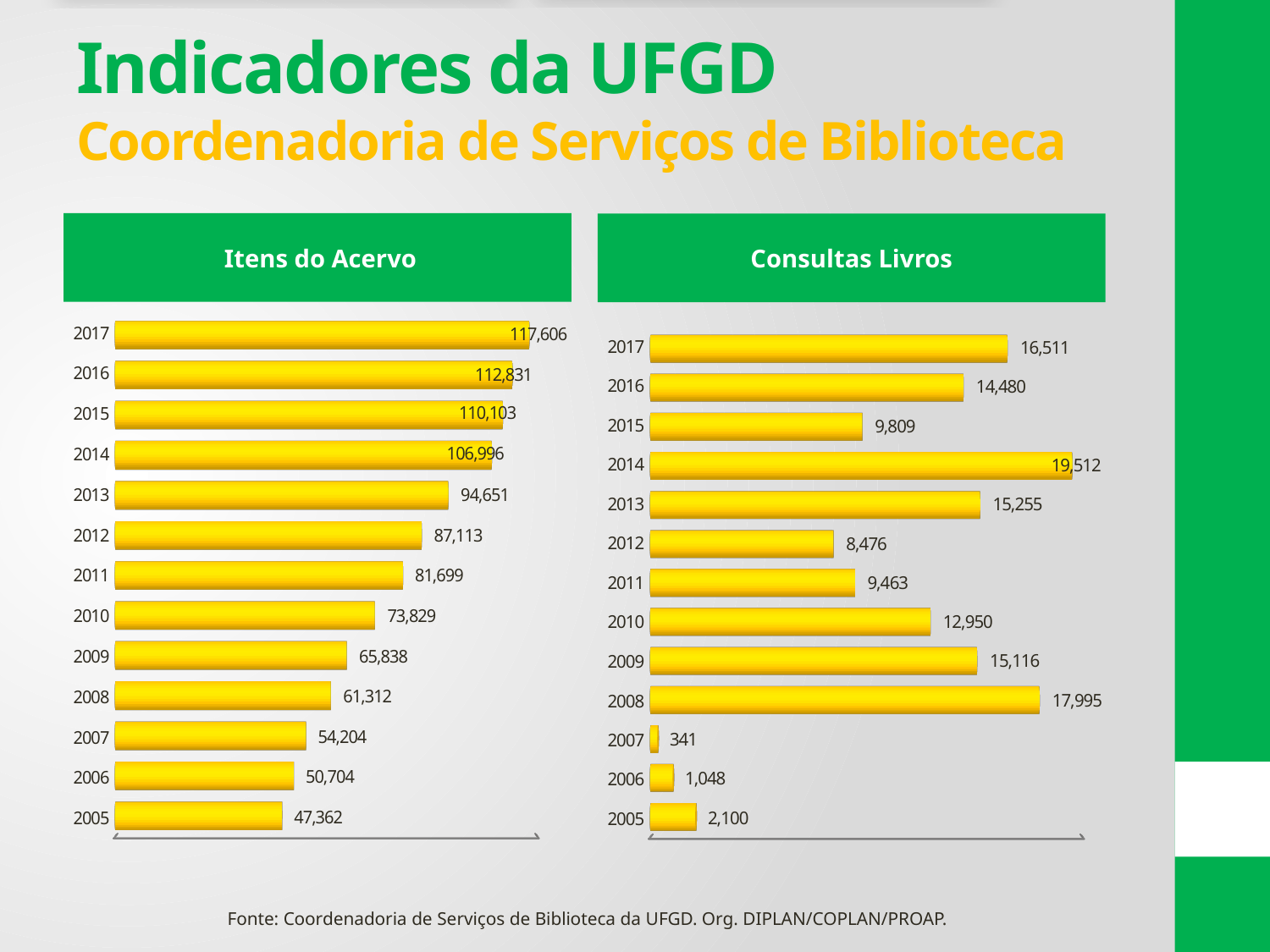
In the 'Consultas Livros' chart, what is the value for 2014? 19,512 In the 'Consultas Livros' chart, what is the difference between the values for 2017 and 2016? 2,031 In the 'Consultas Livros' chart, what is the value for 2007? 341 What kind of chart is the 'Consultas Livros' chart? Bar chart In the 'Consultas Livros' chart, which year has the lowest value? 2007 How many years are shown in the 'Itens do Acervo' chart? 13 In the 'Consultas Livros' chart, which year has the highest value? 2014 In the 'Itens do Acervo' chart, what is the value for 2010? 73,829 In the 'Itens do Acervo' chart, which year has the lowest value? 2005 In the 'Itens do Acervo' chart, what is the value for 2017? 117,606 In the 'Consultas Livros' chart, which is larger, the value for 2008 or the value for 2013? 2008 In the 'Itens do Acervo' chart, what is the difference between the values for 2017 and 2005? 70,244